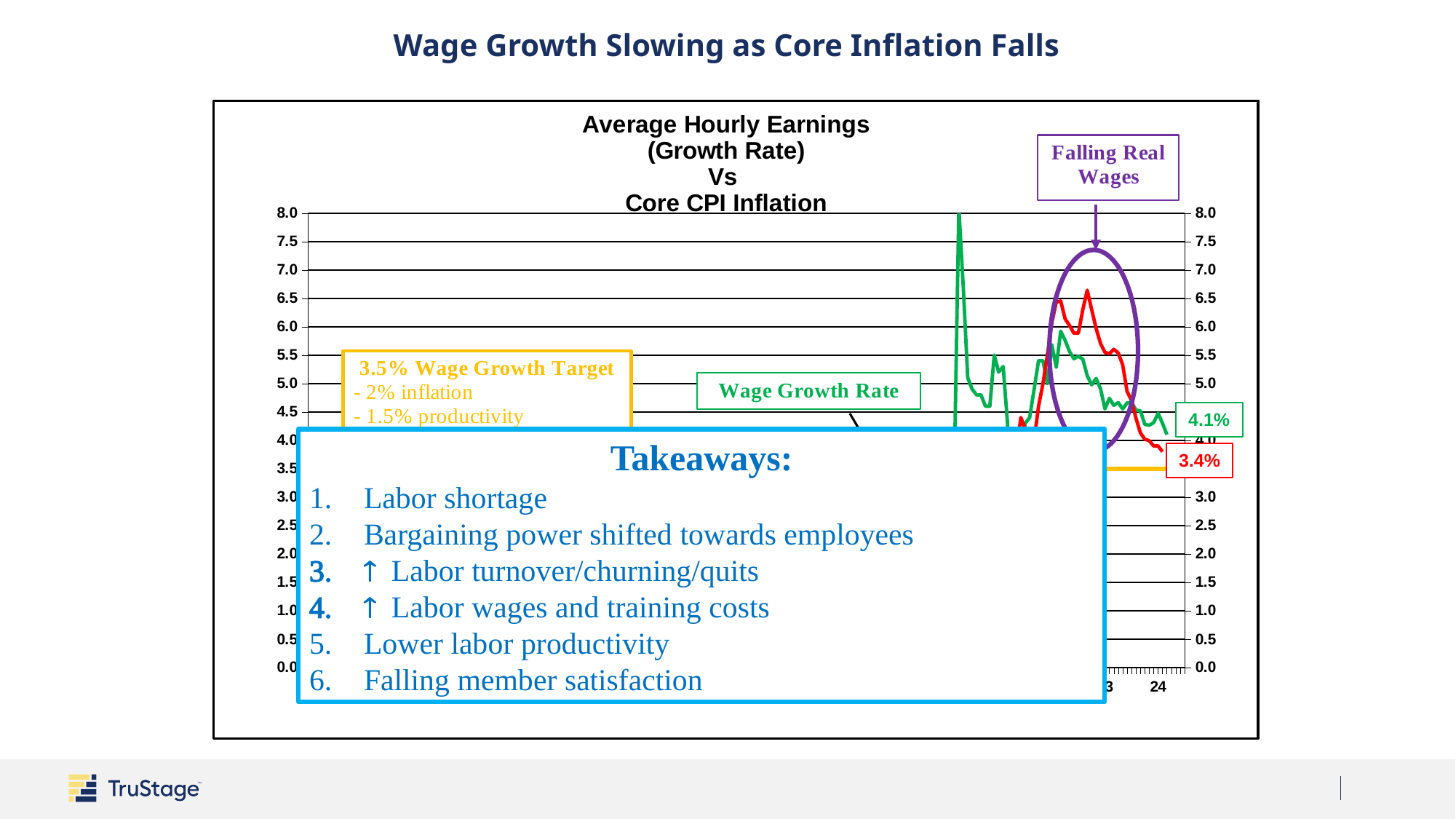
What does the purple annotation box above the circled area say? Falling Real Wages Is the latest labeled Core CPI Inflation value greater or less than 3.5? less What is the difference between the latest labeled Wage Growth Rate (4.1%) and the latest labeled Core CPI Inflation (3.4%)? 0.7% What is the latest labeled value of the Core CPI Inflation (red line)? 3.4% What wage growth target is marked on the chart? 3.5% Is the latest labeled Wage Growth Rate value greater or less than 4.0? greater Does the red Core CPI Inflation line rise or fall after its peak inside the purple circle? fall What kind of chart is shown on the slide? line chart Which is larger at the end of the chart, the Wage Growth Rate or Core CPI Inflation? Wage Growth Rate Is the peak of the green Wage Growth Rate line greater or less than 7.0? greater What is the latest labeled value of the Wage Growth Rate (green line)? 4.1%